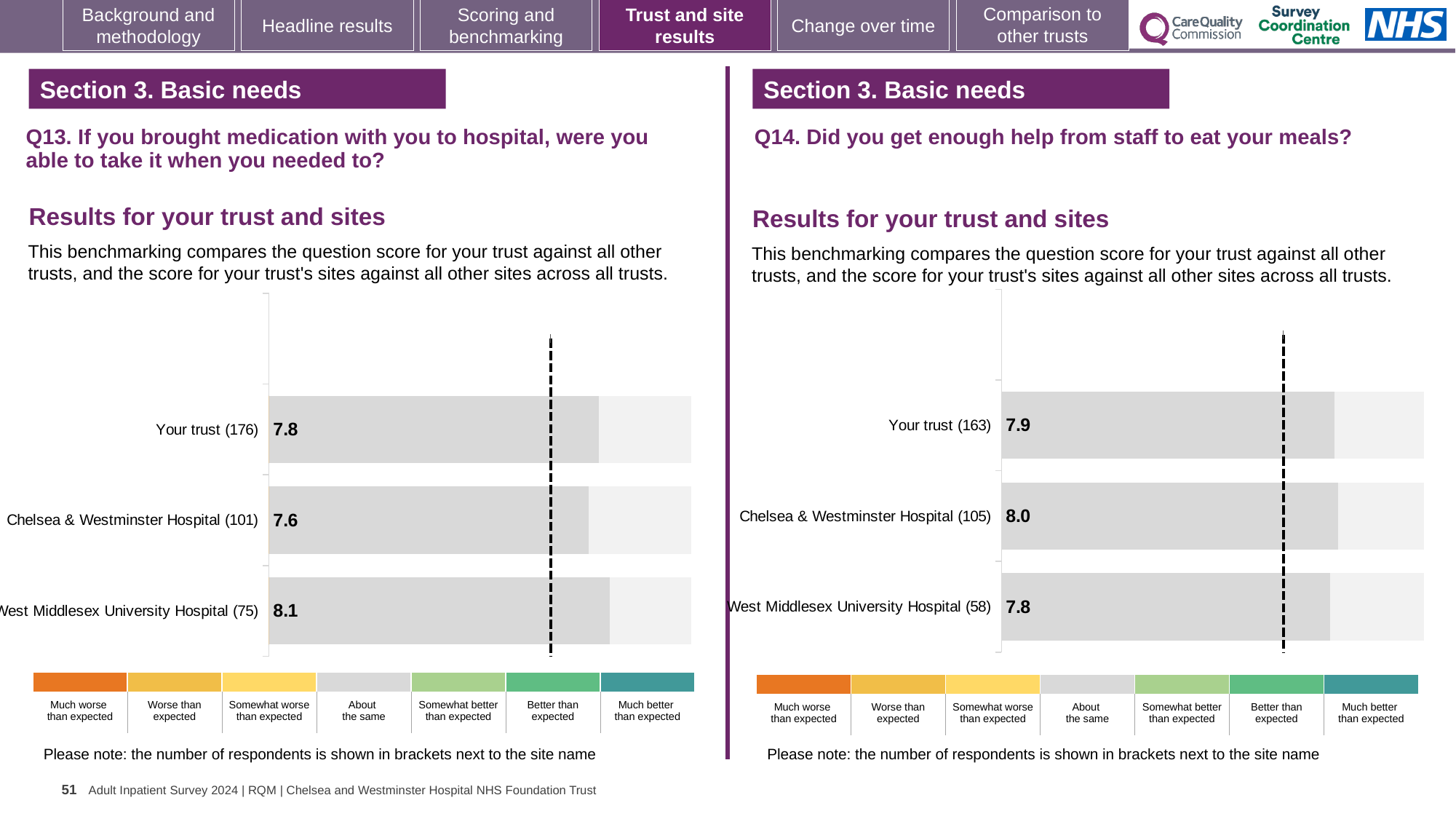
On the Q14 chart (right), is the score for Your trust higher or lower than the score for West Middlesex University Hospital? higher On the Q14 chart (right), which site or trust has the highest score? Chelsea & Westminster Hospital On the Q13 chart (left), what is the score for Your trust? 7.8 On the Q13 chart (left), what is the difference between the scores for West Middlesex University Hospital and Chelsea & Westminster Hospital? 0.5 On the Q13 chart (left), how many respondents are shown in brackets for Your trust? 176 On the Q14 chart (right), what is the score for West Middlesex University Hospital? 7.8 On the Q13 chart (left), which site or trust has the lowest score? Chelsea & Westminster Hospital On the Q14 chart (right), what is the difference between the scores for Chelsea & Westminster Hospital and West Middlesex University Hospital? 0.2 What type of chart is used on the Q14 chart (right)? bar chart On the Q14 chart (right), what is the score for Chelsea & Westminster Hospital? 8.0 On the Q13 chart (left), what is the score for West Middlesex University Hospital? 8.1 On the Q13 chart (left), how many bars are plotted? 3